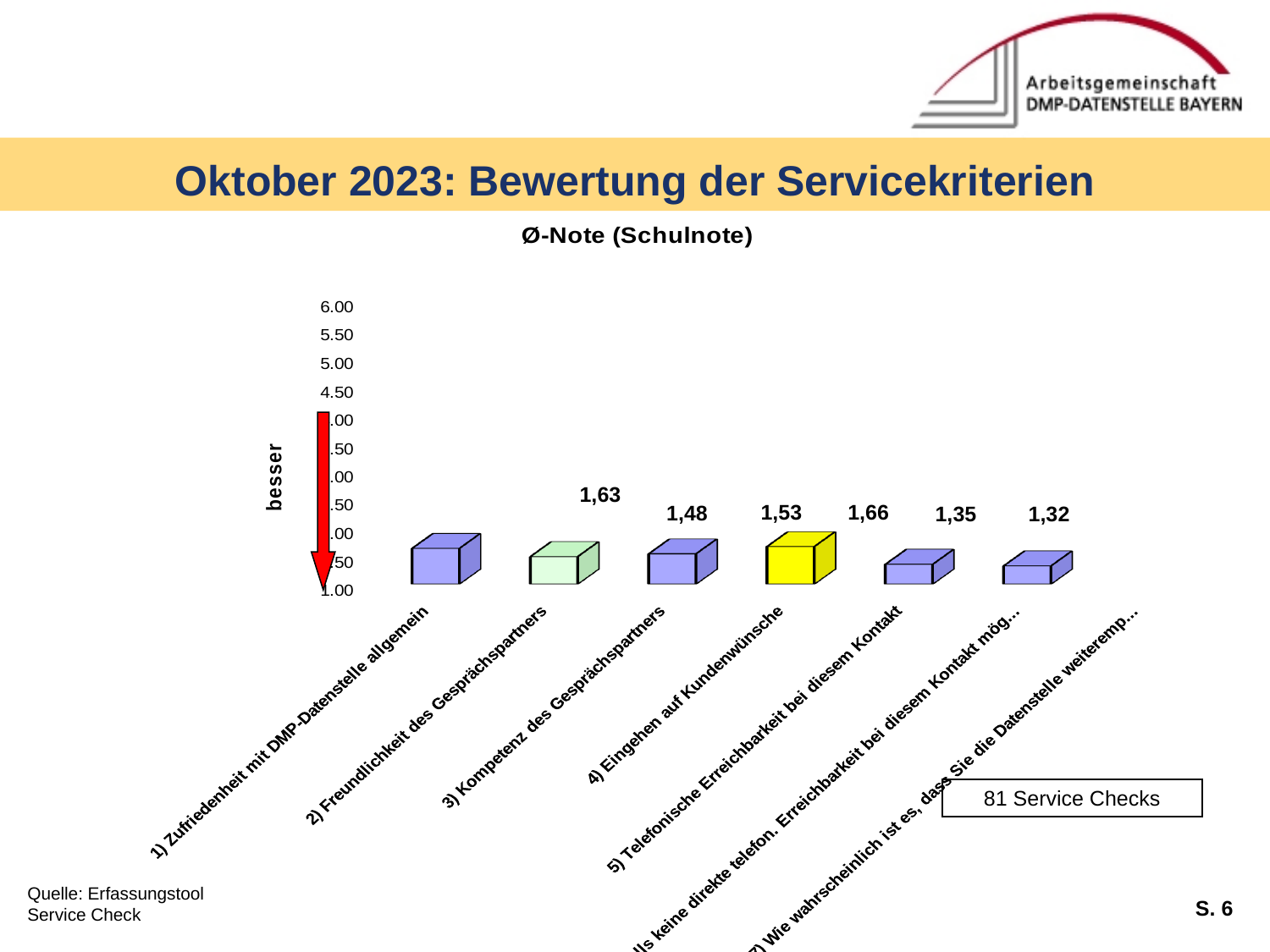
How many categories are shown on the x axis? 7 What kind of chart is shown on the slide? Bar chart Is the value for '1) Zufriedenheit mit DMP-Datenstelle allgemein' greater or less than 2.00? less What is the value for '3) Kompetenz des Gesprächspartners'? 1,53 Which has the larger value: '2) Freundlichkeit des Gesprächspartners' or '3) Kompetenz des Gesprächspartners'? 3) Kompetenz des Gesprächspartners What is the value for '2) Freundlichkeit des Gesprächspartners'? 1,48 What is the value for '5) Telefonische Erreichbarkeit bei diesem Kontakt'? 1,35 Which of the labeled categories has the lowest value? 6) Falls keine direkte telefon. Erreichbarkeit bei diesem Kontakt mög… What is the title of the chart? Ø-Note (Schulnote) What is the difference between the values for '5) Telefonische Erreichbarkeit bei diesem Kontakt' and '3) Kompetenz des Gesprächspartners'? 0,18 What is the value for '4) Eingehen auf Kundenwünsche'? 1,66